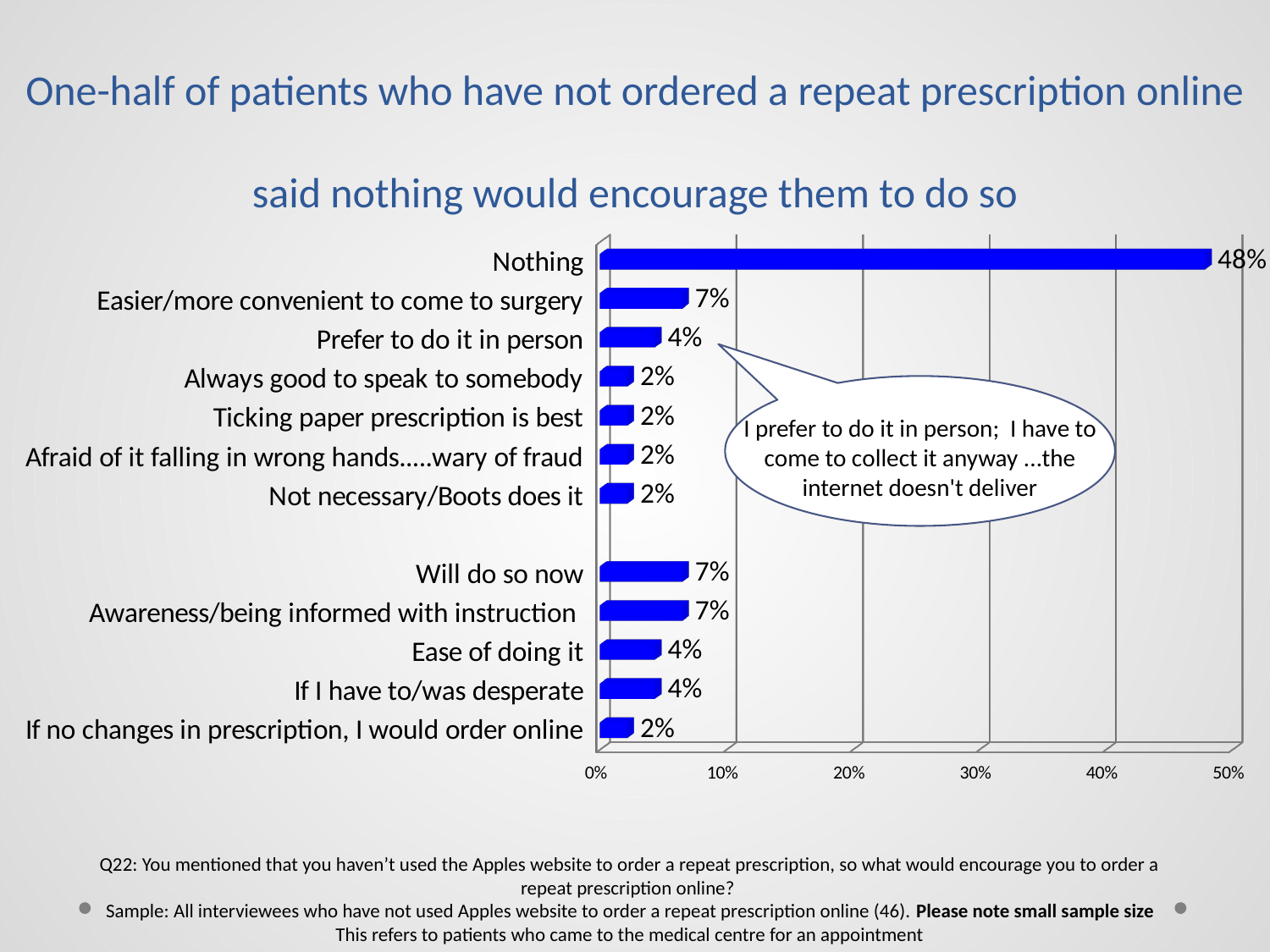
What is the value for "Prefer to do it in person"? 4% What is the value for "Awareness/being informed with instruction"? 7% What is the difference in percentage points between "Nothing" and "Will do so now"? 41 percentage points What kind of chart is shown on the slide? Bar chart Is the value for "Nothing" greater or less than 40%? greater Which category has the highest value in the chart? Nothing Which is larger: the value for "Ease of doing it" or the value for "Always good to speak to somebody"? Ease of doing it What is the value for "If no changes in prescription, I would order online"? 2% What is the highest value shown on the horizontal axis of the chart? 50% How many labelled categories are shown in the chart? 12 What percentage of patients said "Nothing" would encourage them to order a repeat prescription online? 48% What is the value for "Easier/more convenient to come to surgery"? 7%